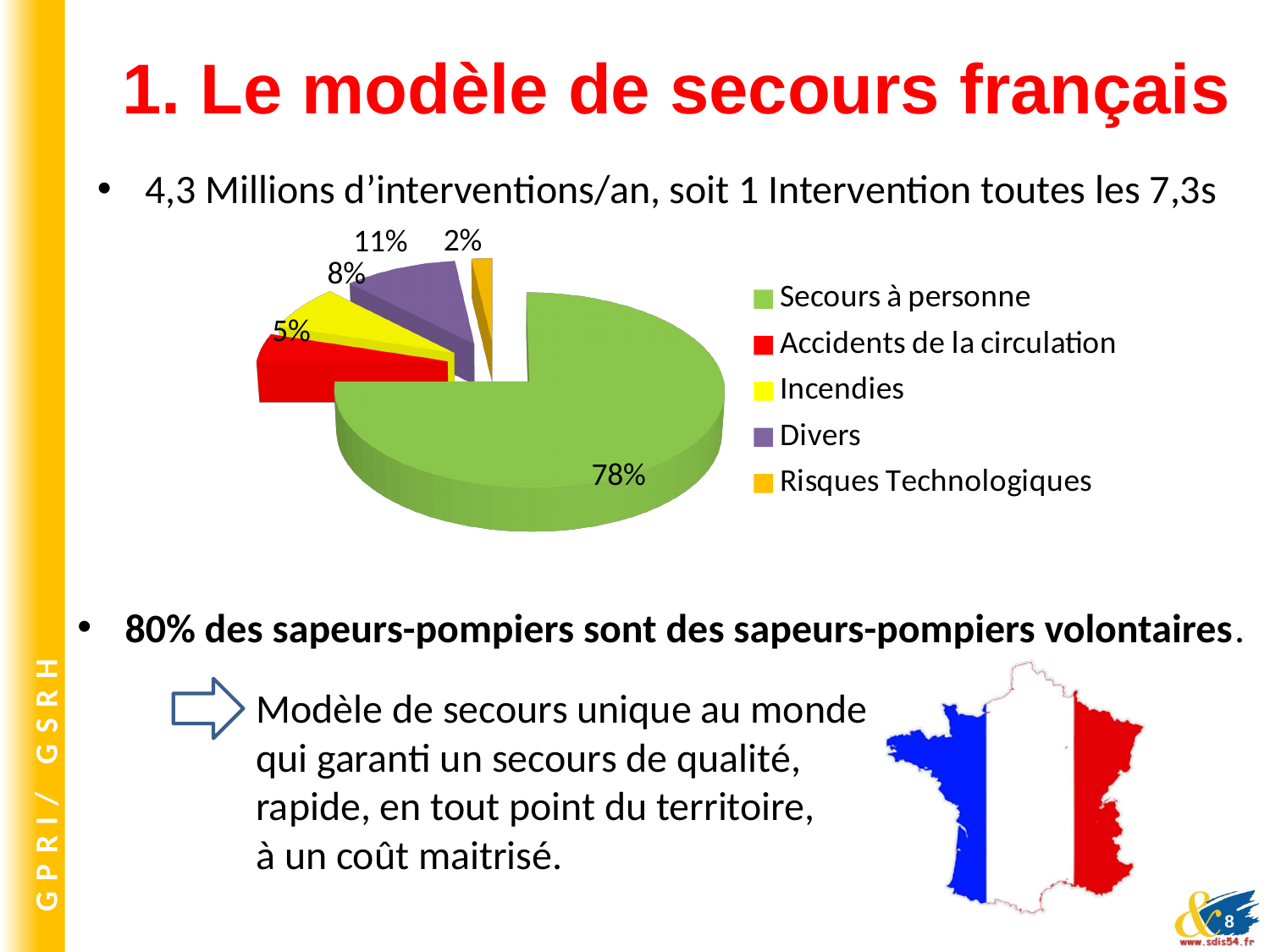
What share of the pie does Accidents de la circulation represent? 5% Which is larger, the share for Incendies or the share for Accidents de la circulation? Incendies Which category has the smallest slice of the pie? Risques Technologiques How many categories does the pie chart show? 5 What share of the pie does Secours à personne represent? 78% What colour is the slice for Secours à personne? green What is the difference in percentage points between Divers and Incendies? 3 Which category has the largest slice of the pie? Secours à personne What kind of chart is shown on the slide? pie chart What share of the pie does Incendies represent? 8%